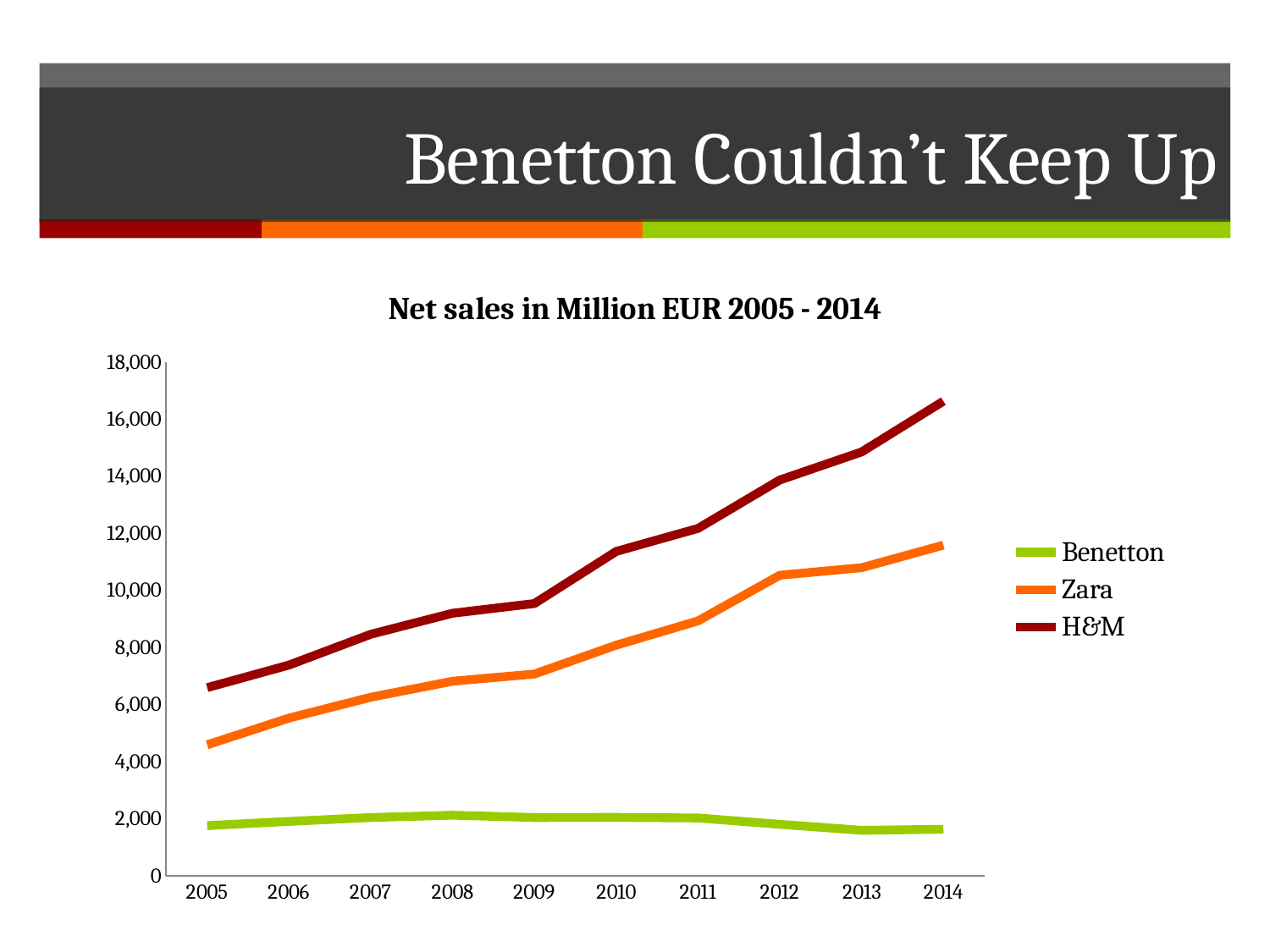
In 2010, which is larger: the value for Zara or the value for Benetton? Zara Is the value for Zara in 2005 greater or less than 4,000? greater Which series has the highest net sales in 2014? H&M What kind of chart is shown on the slide? line chart How many series does the legend list? 3 Do H&M's net sales rise or fall from 2005 to 2014? rise How many years are plotted along the x axis? 10 What is the title of the chart? Net sales in Million EUR 2005 - 2014 Which series has the lowest net sales across all years shown? Benetton Is the value for Zara in 2014 greater or less than 12,000? less Is the value for Benetton in 2014 greater or less than 2,000? less